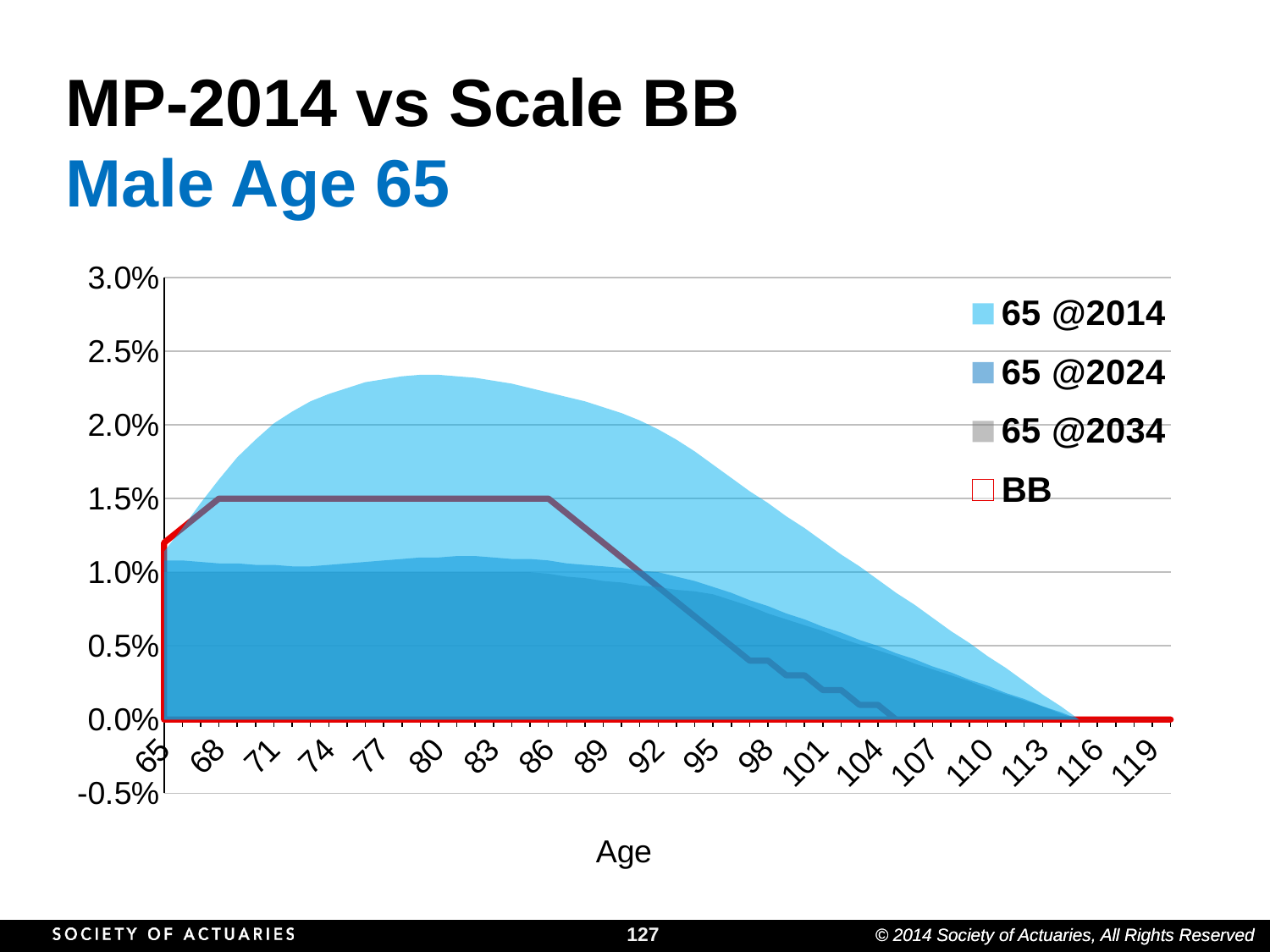
Does the 65 @2014 series rise or fall between age 86 and age 116? fall Is the value for 65 @2024 at age 80 greater or less than 1.5%? less What kind of chart is shown on the slide? area chart Is the value for 65 @2014 at age 92 greater or less than 1.5%? greater Is the value for 65 @2014 at age 80 greater or less than 2.0%? greater At age 104, which is higher: 65 @2014 or BB? 65 @2014 At age 80, which is higher: 65 @2014 or BB? 65 @2014 Which series is drawn as a red line rather than a shaded area? BB How many age labels are shown on the x axis? 19 What value does the BB line hold flat between ages 68 and 86? 1.5% How many series does the legend list? 4 What is the label of the x axis? Age